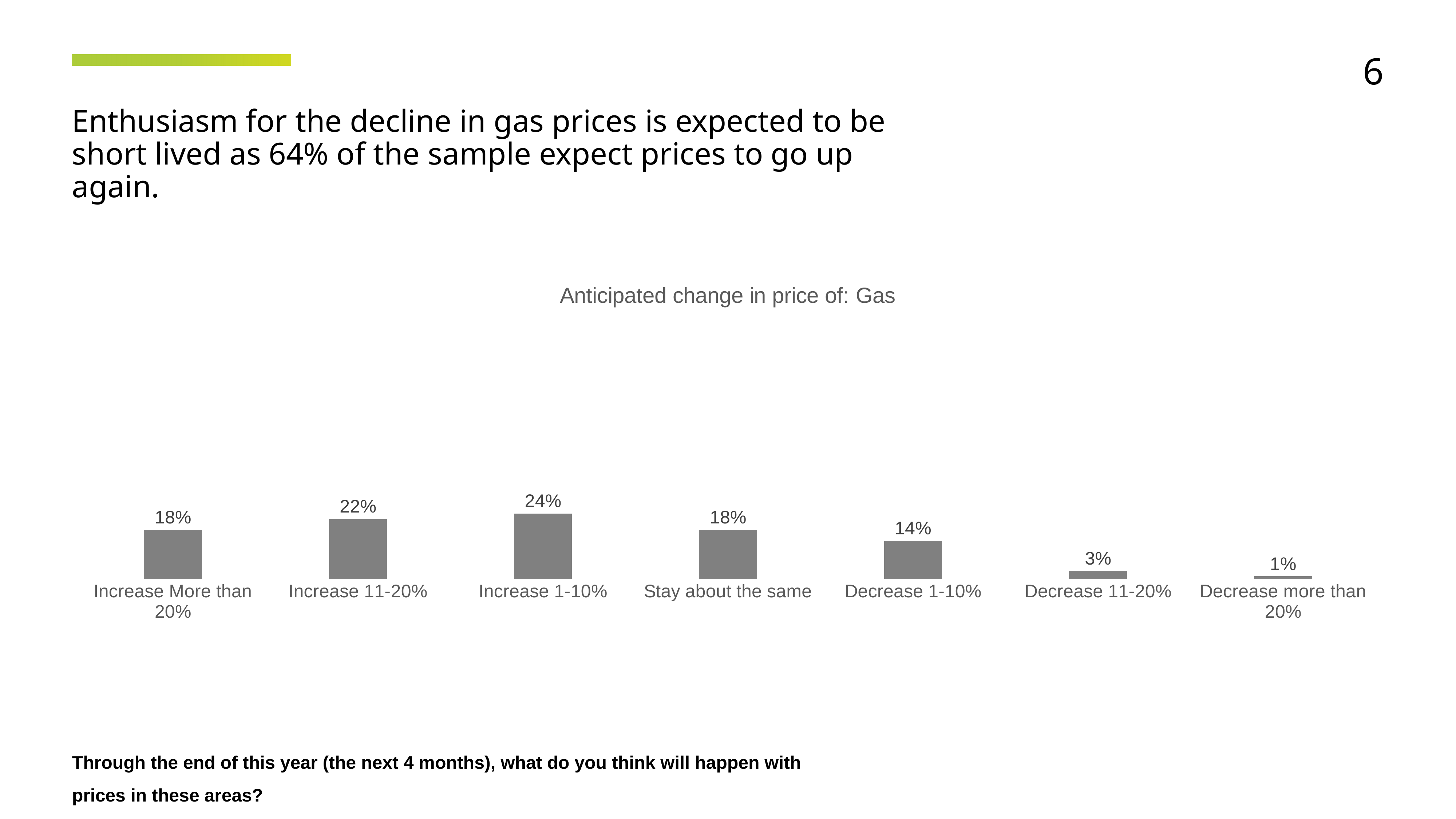
Which is larger, the value for Increase 11-20% or the value for Stay about the same? Increase 11-20% What is the value for Stay about the same? 18% How many categories are shown on the x axis? 7 What is the value for Increase 1-10%? 24% What is the value for Decrease 11-20%? 3% What is the difference between the values for Increase 11-20% and Decrease 1-10%? 8% What is the value for Decrease 1-10%? 14% What is the total of the values for Decrease 1-10%, Decrease 11-20% and Decrease more than 20%? 18% Which category has the highest value? Increase 1-10% What kind of chart is shown on the slide? Bar chart What is the title of the chart? Anticipated change in price of: Gas Which category has the lowest value? Decrease more than 20%